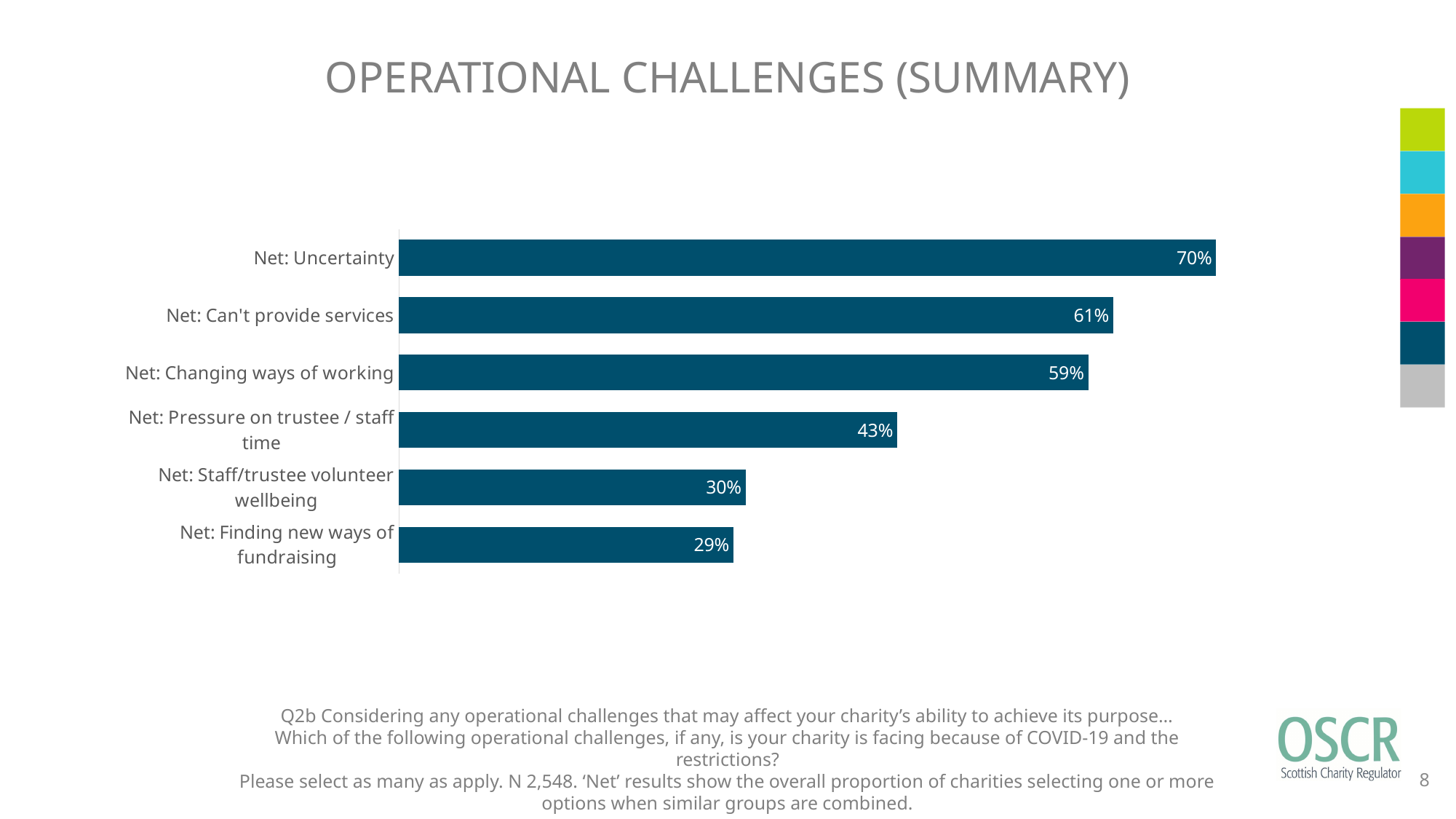
What kind of chart is shown on the slide? Bar chart What is the value for Net: Can't provide services? 61% What is the difference between Net: Can't provide services and Net: Pressure on trustee / staff time? 18 percentage points What is the value for Net: Uncertainty? 70% Which category has the lowest value? Net: Finding new ways of fundraising What is the value for Net: Pressure on trustee / staff time? 43% Which category has the highest value? Net: Uncertainty What is the difference between Net: Uncertainty and Net: Changing ways of working? 11 percentage points How many categories are shown in the chart? 6 What is the value for Net: Finding new ways of fundraising? 29% Which is larger: Net: Changing ways of working or Net: Staff/trustee volunteer wellbeing? Net: Changing ways of working What is the title of the slide? OPERATIONAL CHALLENGES (SUMMARY)